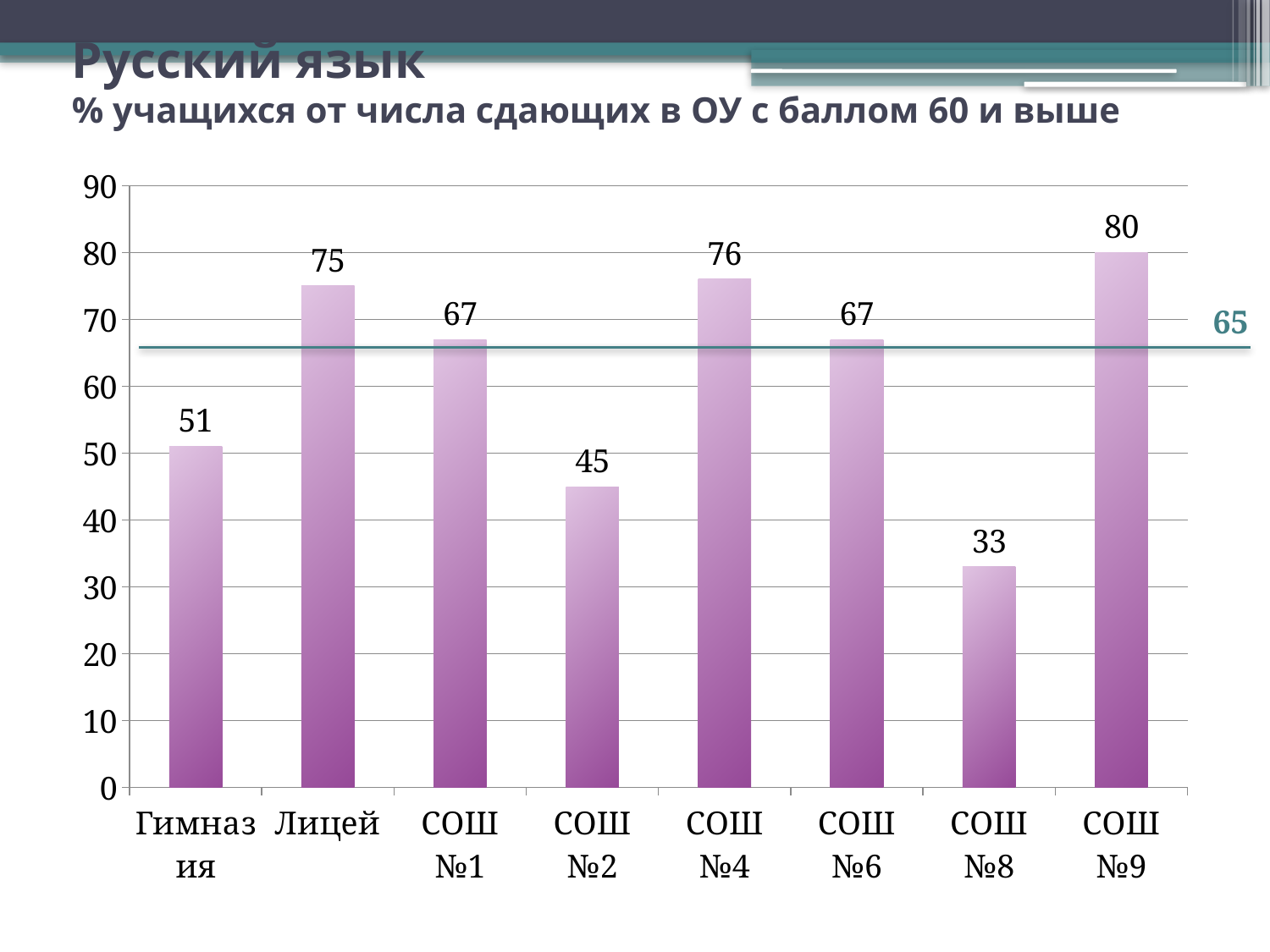
Which is larger, the value for Лицей or the value for СОШ №4? СОШ №4 What is the difference between the values for СОШ №4 and СОШ №2? 31 How many categories are shown on the x axis? 8 What is the value for Лицей? 75 What kind of chart is shown on the slide? bar chart What is the value for Гимназия? 51 Which category has the highest value? СОШ №9 What is the value for СОШ №8? 33 What value is labelled on the horizontal reference line across the chart? 65 Which category has the lowest value? СОШ №8 What is the difference between the values for СОШ №9 and СОШ №8? 47 Is the value for СОШ №2 greater or less than 50? less